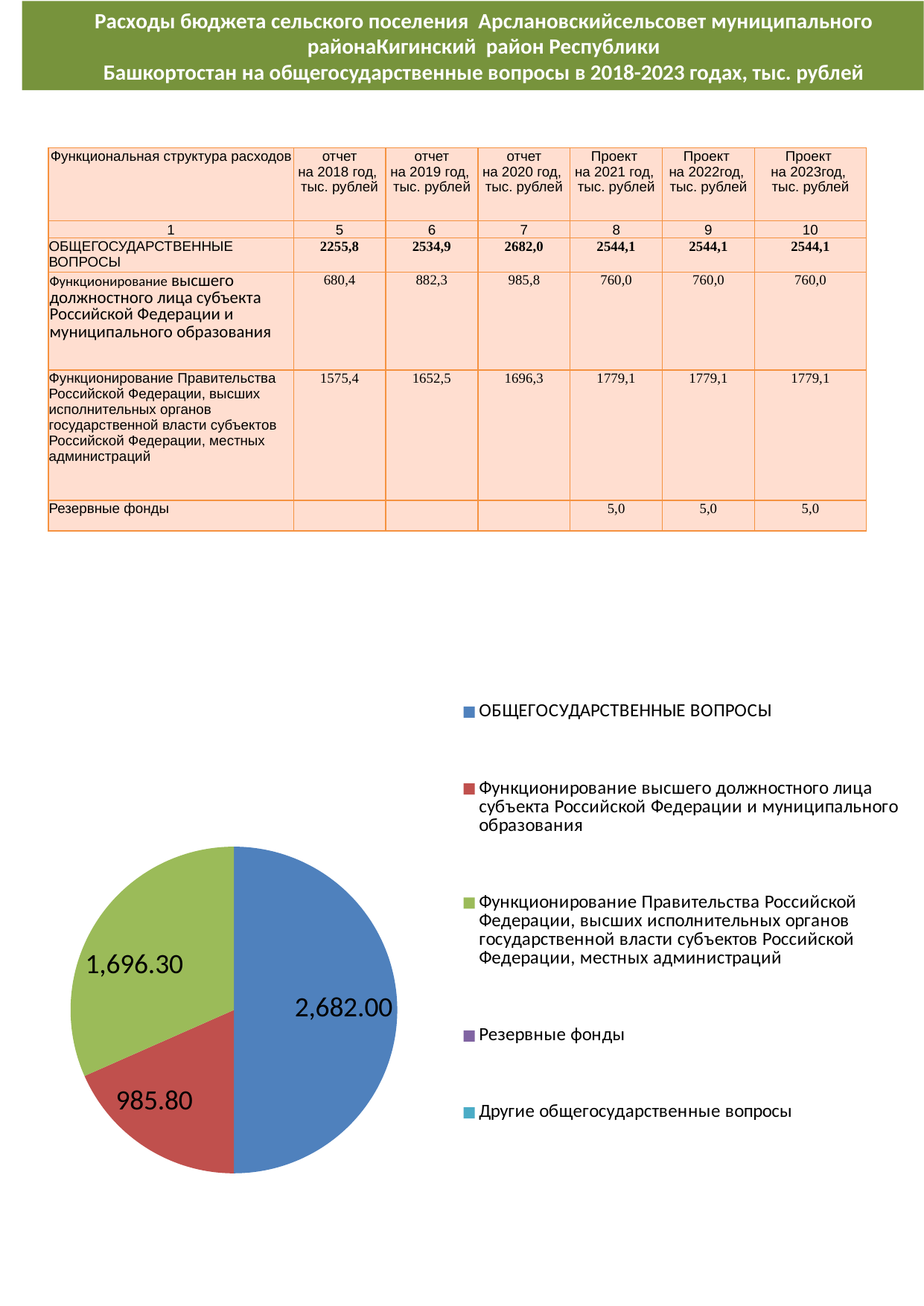
What kind of chart is shown on the slide? pie chart What value is shown for the ОБЩЕГОСУДАРСТВЕННЫЕ ВОПРОСЫ slice of the pie chart? 2,682.00 What is the difference between the ОБЩЕГОСУДАРСТВЕННЫЕ ВОПРОСЫ slice and the 'Функционирование Правительства Российской Федерации...' slice in the pie chart? 985.70 What value is shown for the slice 'Функционирование Правительства Российской Федерации, высших исполнительных органов государственной власти субъектов Российской Федерации, местных администраций' in the pie chart? 1,696.30 How many slices with data labels are visible in the pie chart? 3 What value is shown for the slice 'Функционирование высшего должностного лица субъекта Российской Федерации и муниципального образования' in the pie chart? 985.80 What colour is the ОБЩЕГОСУДАРСТВЕННЫЕ ВОПРОСЫ slice in the pie chart? blue Which slice of the pie chart has the largest value? ОБЩЕГОСУДАРСТВЕННЫЕ ВОПРОСЫ Which labelled slice of the pie chart has the smallest value? Функционирование высшего должностного лица субъекта Российской Федерации и муниципального образования How many entries does the legend of the pie chart list? 5 What is the difference between the 'Функционирование Правительства Российской Федерации...' slice and the 'Функционирование высшего должностного лица...' slice in the pie chart? 710.50 In the pie chart, which is larger: the 'Функционирование Правительства Российской Федерации...' slice or the 'Функционирование высшего должностного лица...' slice? Функционирование Правительства Российской Федерации, высших исполнительных органов государственной власти субъектов Российской Федерации, местных администраций